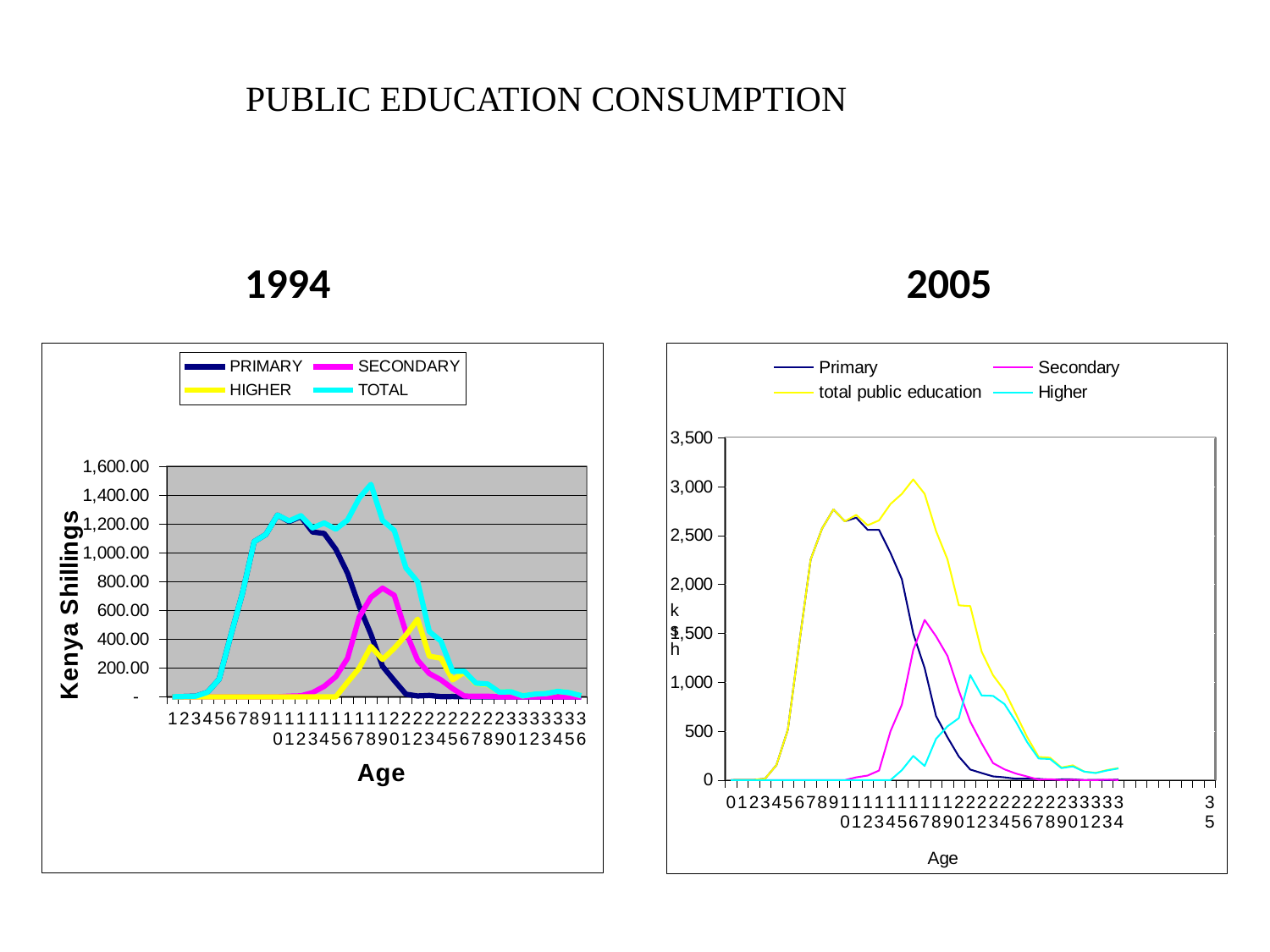
In the 2005 chart, is the peak value of the Higher series greater or less than 1,500? less In the 1994 chart, is the peak value of the SECONDARY series greater or less than 600.00? greater In the 1994 chart, does the PRIMARY series rise or fall between age 12 and age 20? fall How many series does the legend of the 2005 chart list? 4 What is the y-axis title of the 1994 chart? Kenya Shillings In the 2005 chart, which series reaches a higher peak, Secondary or Higher? Secondary How many series does the legend of the 1994 chart list? 4 What kind of chart is the 1994 chart? line chart In the 2005 chart, which series reaches the highest value? total public education In the 2005 chart, is the peak value of the Primary series greater or less than 2,500? greater In the 1994 chart, which series reaches the highest value? TOTAL